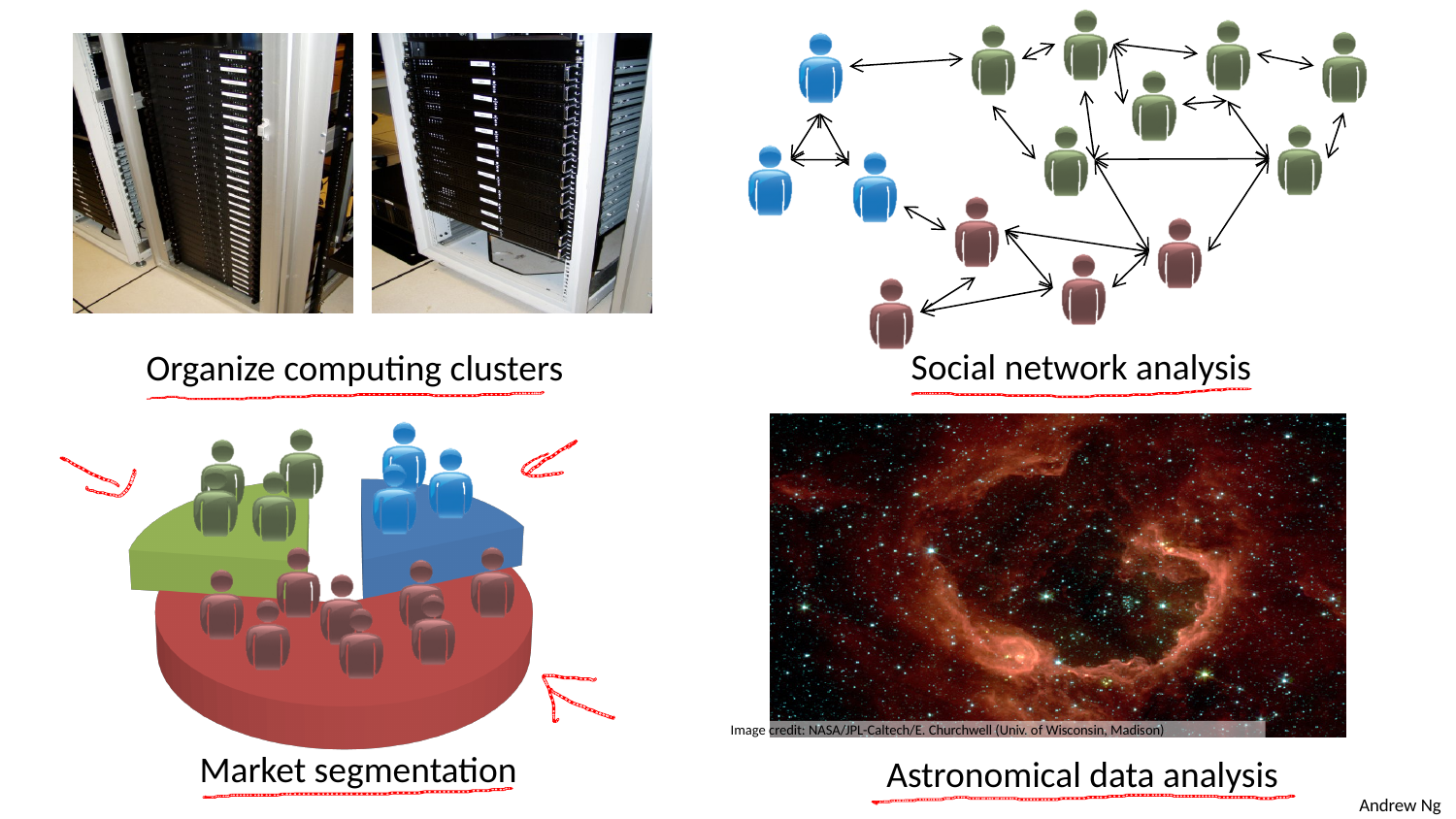
In the pie chart under "Market segmentation", is the red slice larger or smaller than the blue slice? larger What colours are the three slices of the pie chart under "Market segmentation"? green, blue and red In the pie chart under "Market segmentation", which slice is the largest? the red slice Does the pie chart under "Market segmentation" show any numeric data labels? No What kind of chart is shown under the "Market segmentation" label? pie chart How many slices does the pie chart under "Market segmentation" have? 3 In the pie chart under "Market segmentation", is the red slice larger or smaller than the green slice? larger